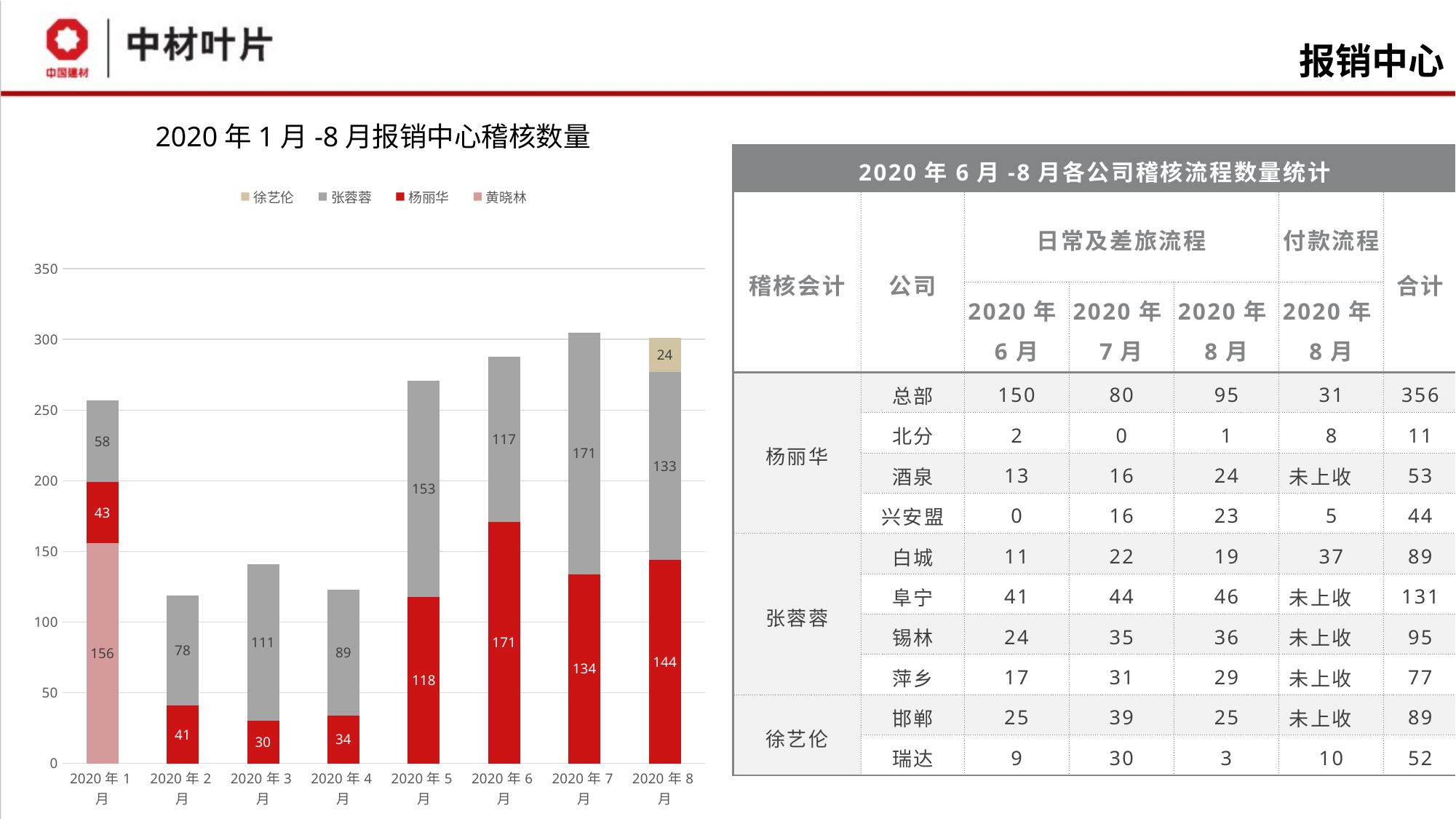
What is the value for 杨丽华 in 2020年6月? 171 What is the difference between the values for 张蓉蓉 and 杨丽华 in 2020年7月? 37 What is the value for 黄晓林 in 2020年1月? 156 In which month is the value for 杨丽华 the lowest? 2020年3月 What type of chart is shown on the slide? stacked bar chart Which is larger in 2020年6月, the value for 杨丽华 or the value for 张蓉蓉? 杨丽华 What is the total of the stacked bar for 2020年8月? 301 How many months are shown on the x axis of the chart? 8 What is the value for 张蓉蓉 in 2020年5月? 153 What is the value for 徐艺伦 in 2020年8月? 24 In which month is the value for 张蓉蓉 the highest? 2020年7月 How many series does the chart legend list? 4